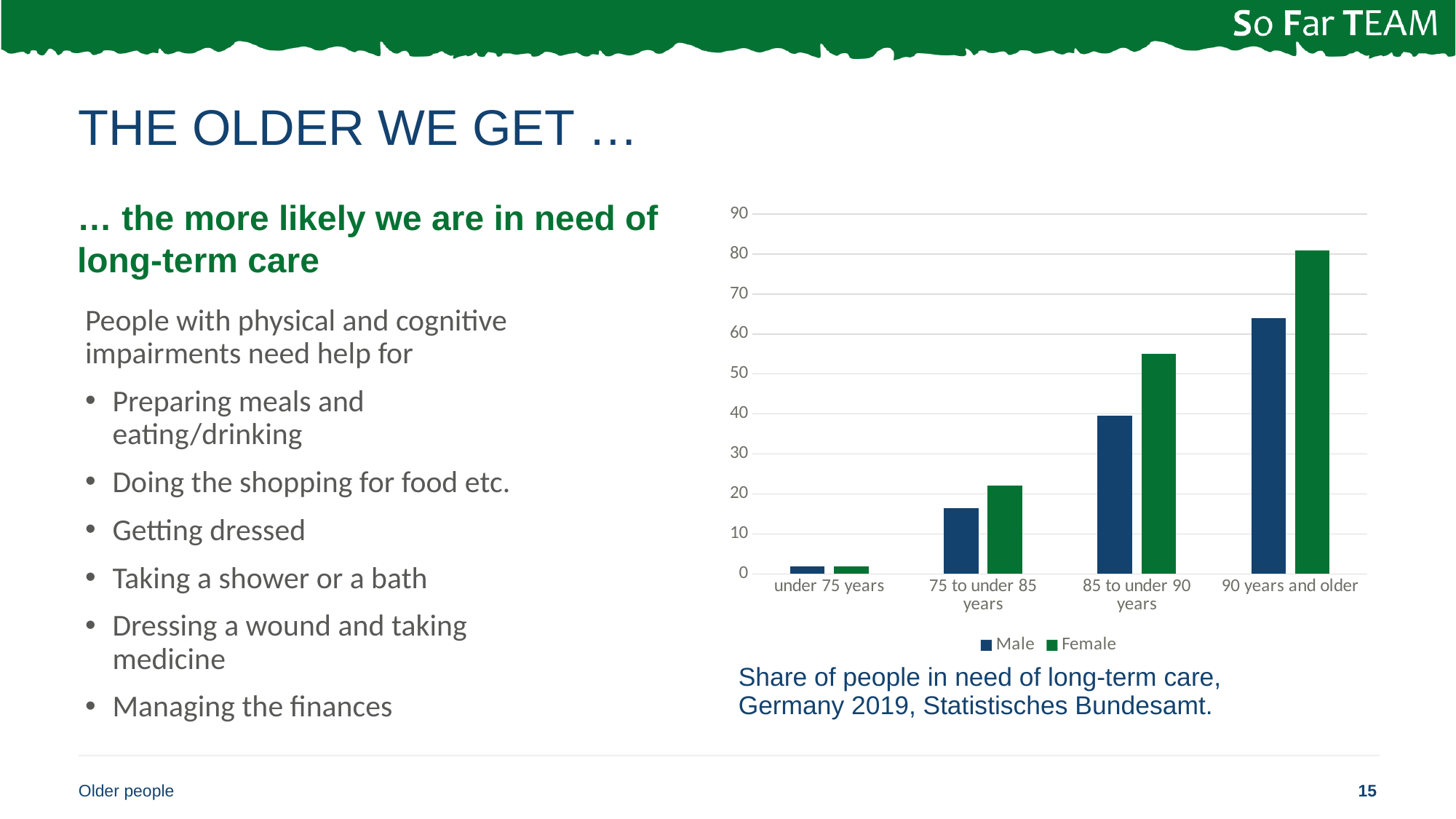
How many age categories are shown on the x axis of the chart? 4 For 85 to under 90 years, which is larger, the Male value or the Female value? Female Which series is shown in green in the chart? Female Is the Male value for 90 years and older greater or less than 70? less Is the Male value for 75 to under 85 years greater or less than 20? less Do the Female values rise or fall as age increases along the x axis? rise Which age category has the highest Female value in the chart? 90 years and older Is the Female value for 85 to under 90 years greater or less than 50? greater What kind of chart is shown on the slide? bar chart How many series does the chart's legend list? 2 Which age category has the lowest Male value in the chart? under 75 years